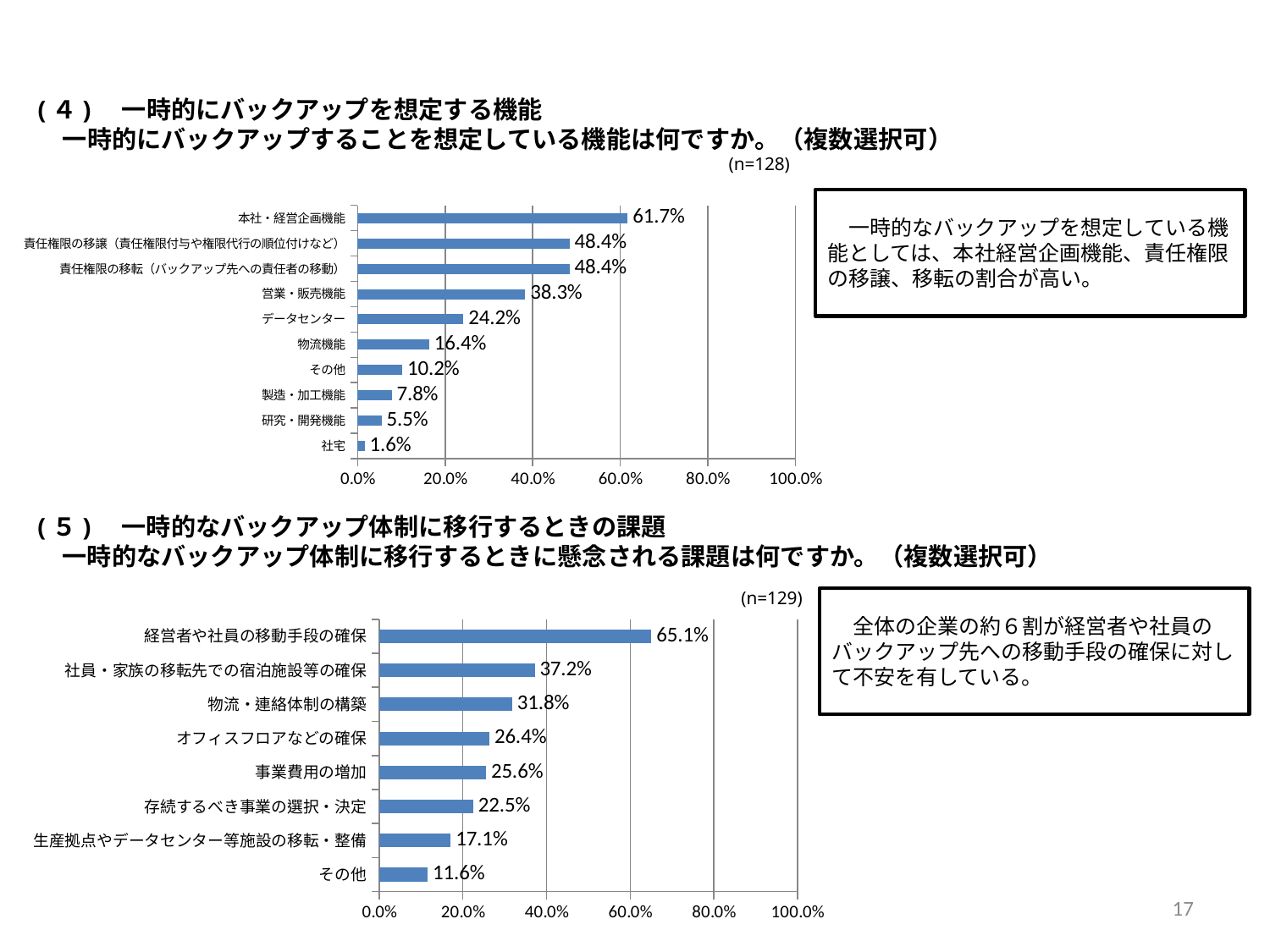
In the top chart (一時的にバックアップを想定する機能), how many categories are plotted? 10 In the top chart (一時的にバックアップを想定する機能), which category has the lowest value? 社宅 In the top chart (一時的にバックアップを想定する機能), what is the value for 本社・経営企画機能? 61.7% In the top chart (一時的にバックアップを想定する機能), is the value for 本社・経営企画機能 greater or less than 60.0%? greater What type of chart is the bottom chart (一時的なバックアップ体制に移行するときの課題)? Bar chart In the bottom chart (一時的なバックアップ体制に移行するときの課題), which category has the highest value? 経営者や社員の移動手段の確保 In the bottom chart (一時的なバックアップ体制に移行するときの課題), which is larger: 物流・連絡体制の構築 or オフィスフロアなどの確保? 物流・連絡体制の構築 In the bottom chart (一時的なバックアップ体制に移行するときの課題), how many categories are plotted? 8 In the top chart (一時的にバックアップを想定する機能), what is the value for データセンター? 24.2% In the top chart (一時的にバックアップを想定する機能), what is the difference between 営業・販売機能 and 物流機能? 21.9% In the bottom chart (一時的なバックアップ体制に移行するときの課題), what is the value for 事業費用の増加? 25.6% In the bottom chart (一時的なバックアップ体制に移行するときの課題), what is the value for 経営者や社員の移動手段の確保? 65.1%